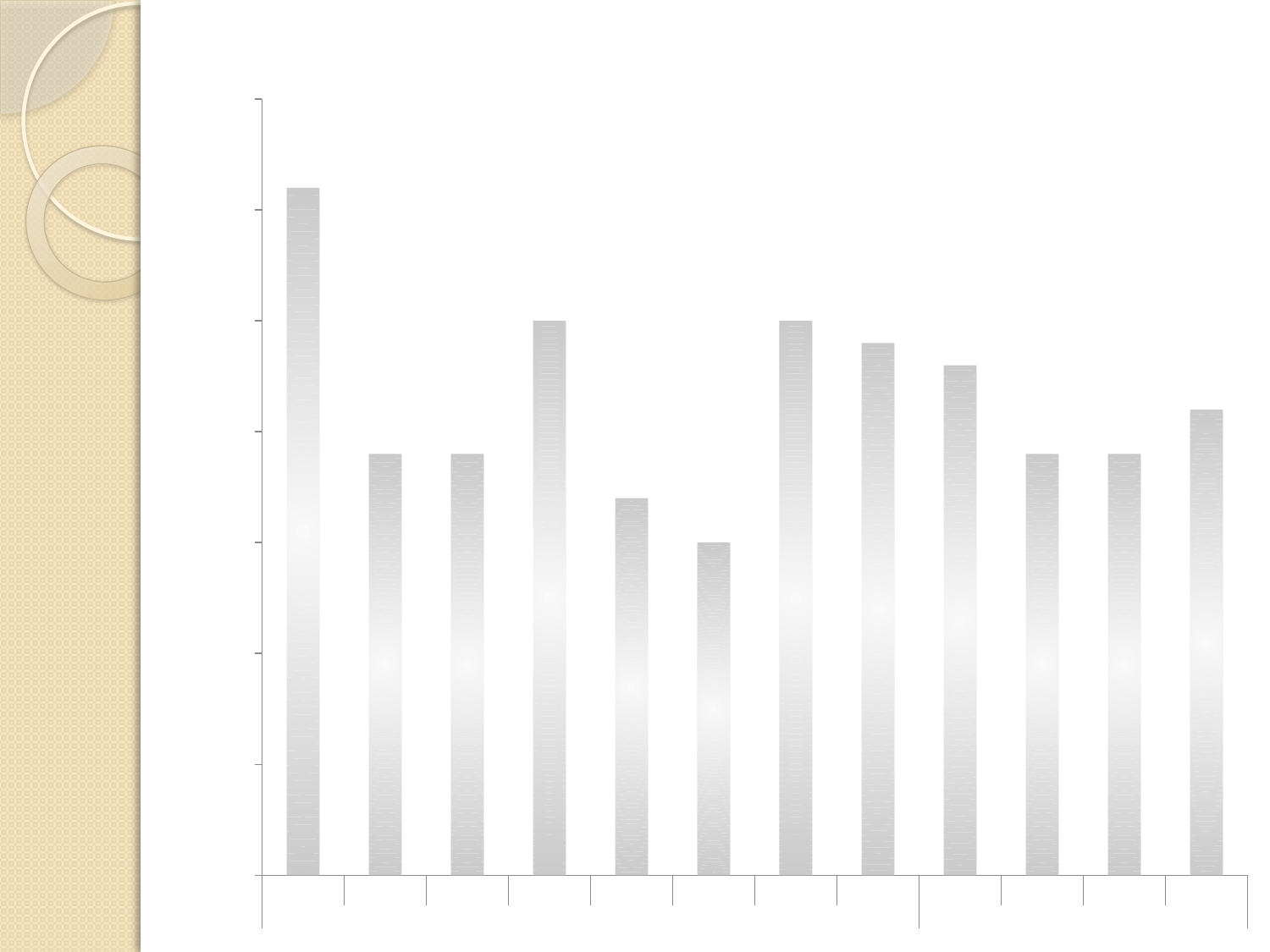
Which is taller, the fifth bar or the seventh bar? the seventh bar Which is taller, the first bar or the fourth bar? the first bar How many bars are plotted in the chart? 12 Which bar in the chart is the tallest? the first (leftmost) bar Which bar in the chart is the shortest? the sixth bar from the left Does the chart show a legend? No What kind of chart is shown on the slide? bar chart Does the chart have a title? No